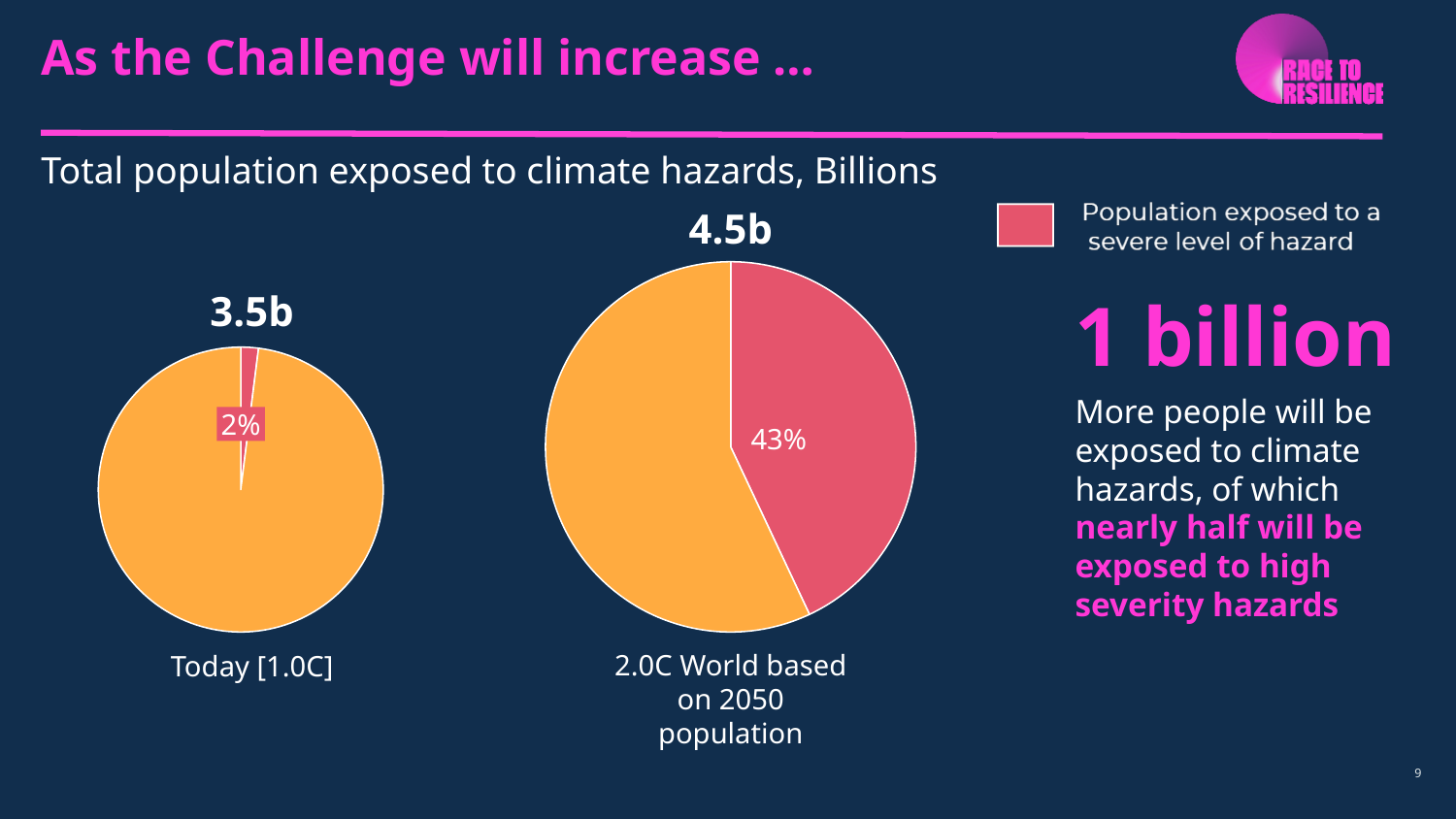
In the 'Today [1.0C]' pie chart, what share of the population is exposed to a severe level of hazard? 2% How many pie charts are on the slide? 2 Is the severe-hazard share in the '2.0C World based on 2050 population' pie chart greater or less than 50%? less What total population is shown above the 'Today [1.0C]' pie chart? 3.5b What is the title of the chart section on the slide? Total population exposed to climate hazards, Billions What kind of charts are shown on the slide? Pie charts What is the difference in total population between the '2.0C World based on 2050 population' chart and the 'Today [1.0C]' chart? 1b In the '2.0C World based on 2050 population' pie chart, what share of the population is exposed to a severe level of hazard? 43% What does the legend say the red/pink slice represents? Population exposed to a severe level of hazard By how many percentage points does the severe-hazard share in the '2.0C World based on 2050 population' chart exceed that in the 'Today [1.0C]' chart? 41 percentage points Which pie chart has the larger share exposed to a severe level of hazard, 'Today [1.0C]' or '2.0C World based on 2050 population'? 2.0C World based on 2050 population What total population is shown above the '2.0C World based on 2050 population' pie chart? 4.5b